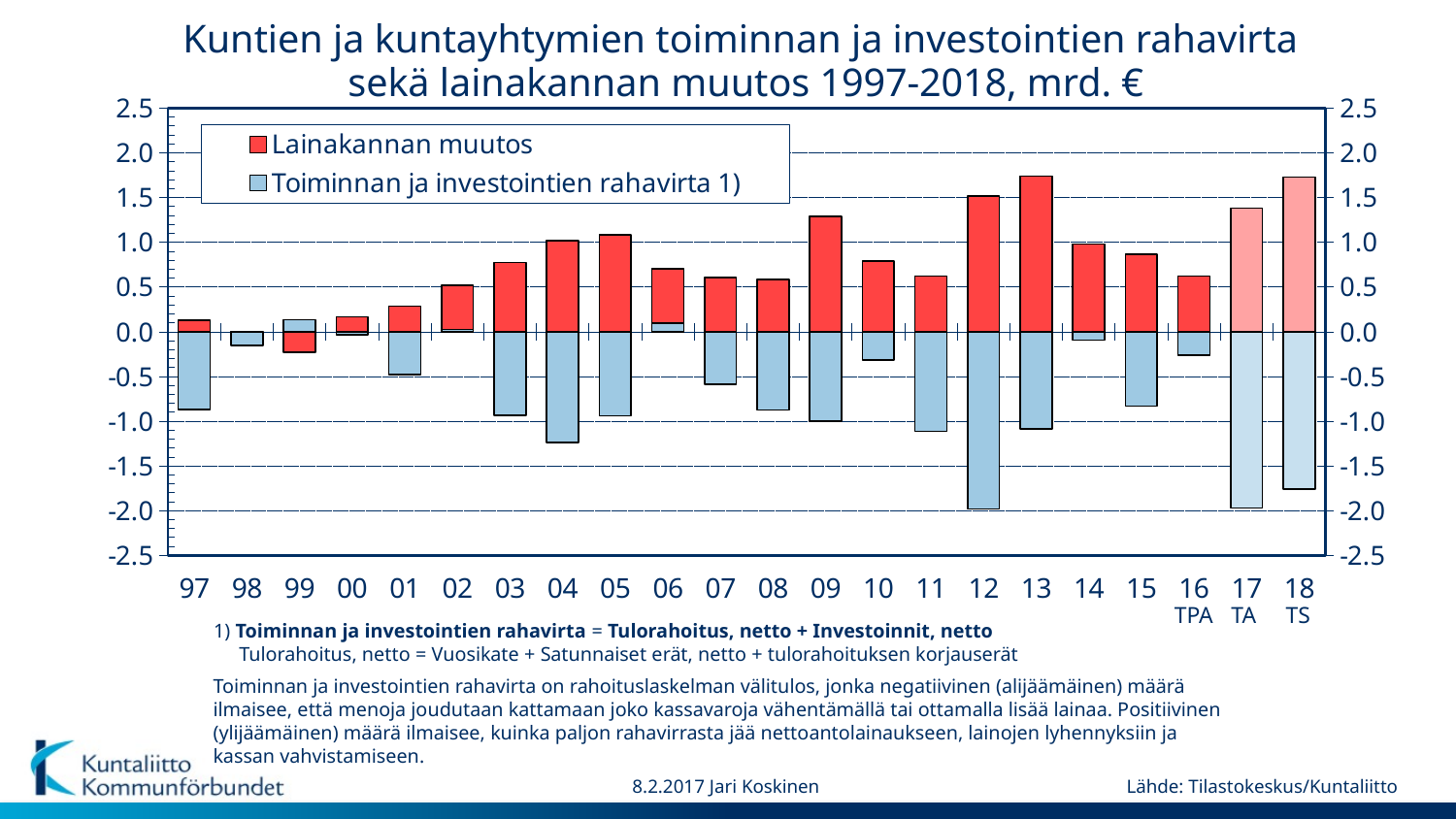
Is the value of Toiminnan ja investointien rahavirta for 04 greater or less than -1.0? less Which is larger, Lainakannan muutos for 09 or for 10? 09 How many series does the legend list? 2 Is the value of Lainakannan muutos for 13 greater or less than 1.5? greater Is the value of Lainakannan muutos for 12 greater or less than 1.0? greater Which is larger, Lainakannan muutos for 12 or for 14? 12 From 99 to 05, does Lainakannan muutos rise or fall? rise How many years (categories) are shown on the x axis? 22 What kind of chart is shown on the slide? bar chart Which series is shown in red in the legend? Lainakannan muutos